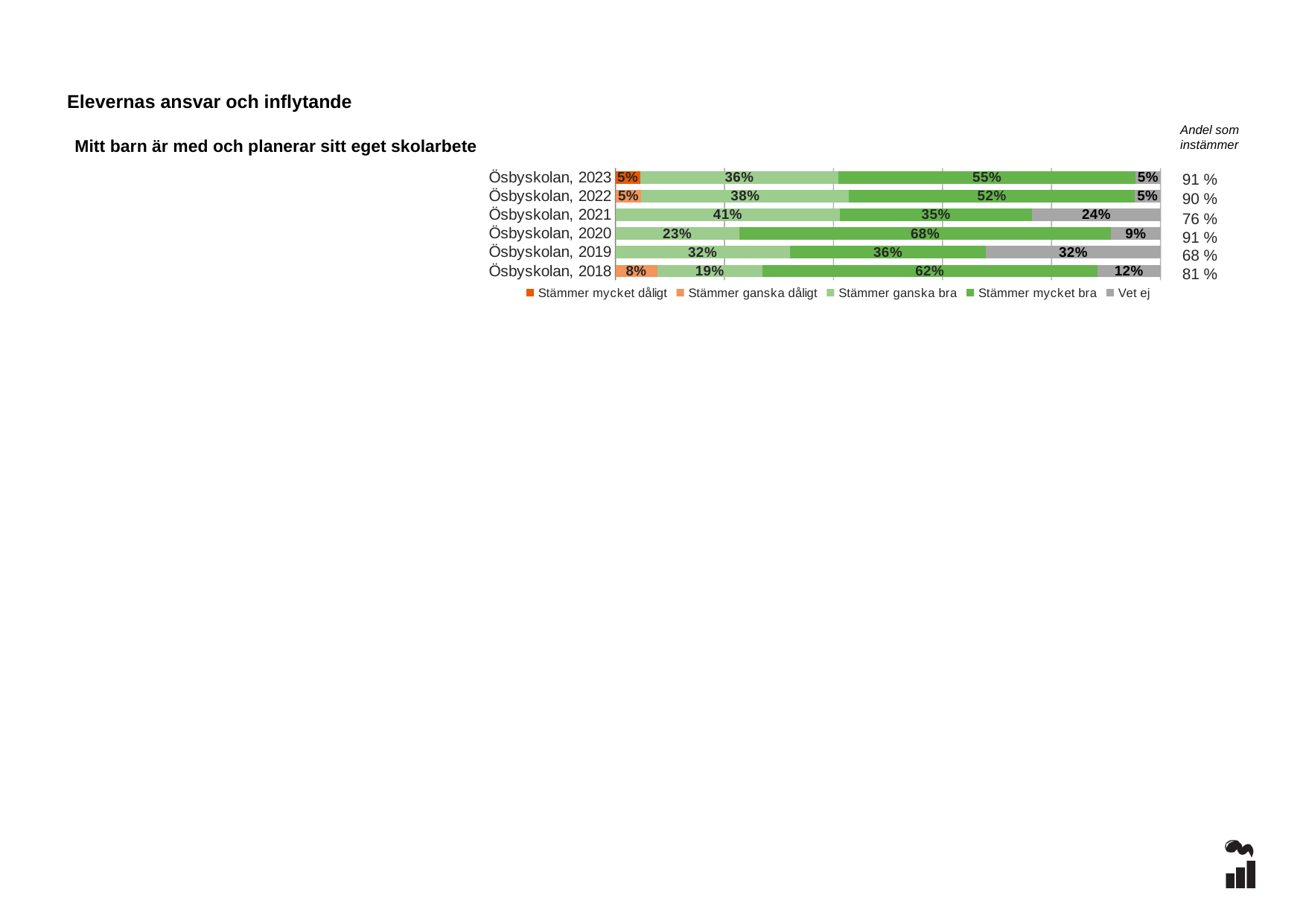
What kind of chart is shown on the slide? Stacked bar chart How many series does the legend list? 5 How many categories (bars) are shown in the chart? 6 Which year has the highest "Vet ej" value? Ösbyskolan, 2019 What is the "Vet ej" value for Ösbyskolan, 2021? 24% What is the "Stämmer ganska dåligt" value for Ösbyskolan, 2018? 8% What is the "Andel som instämmer" figure shown for Ösbyskolan, 2019? 68 % What is the value for "Stämmer mycket bra" for Ösbyskolan, 2020? 68% What is the difference in percentage points between the "Stämmer mycket bra" values for Ösbyskolan, 2020 and Ösbyskolan, 2019? 32 What is the "Stämmer ganska bra" value for Ösbyskolan, 2023? 36% Which year has the highest "Stämmer mycket bra" value? Ösbyskolan, 2020 Which has the larger "Stämmer ganska bra" value, Ösbyskolan, 2021 or Ösbyskolan, 2022? Ösbyskolan, 2021